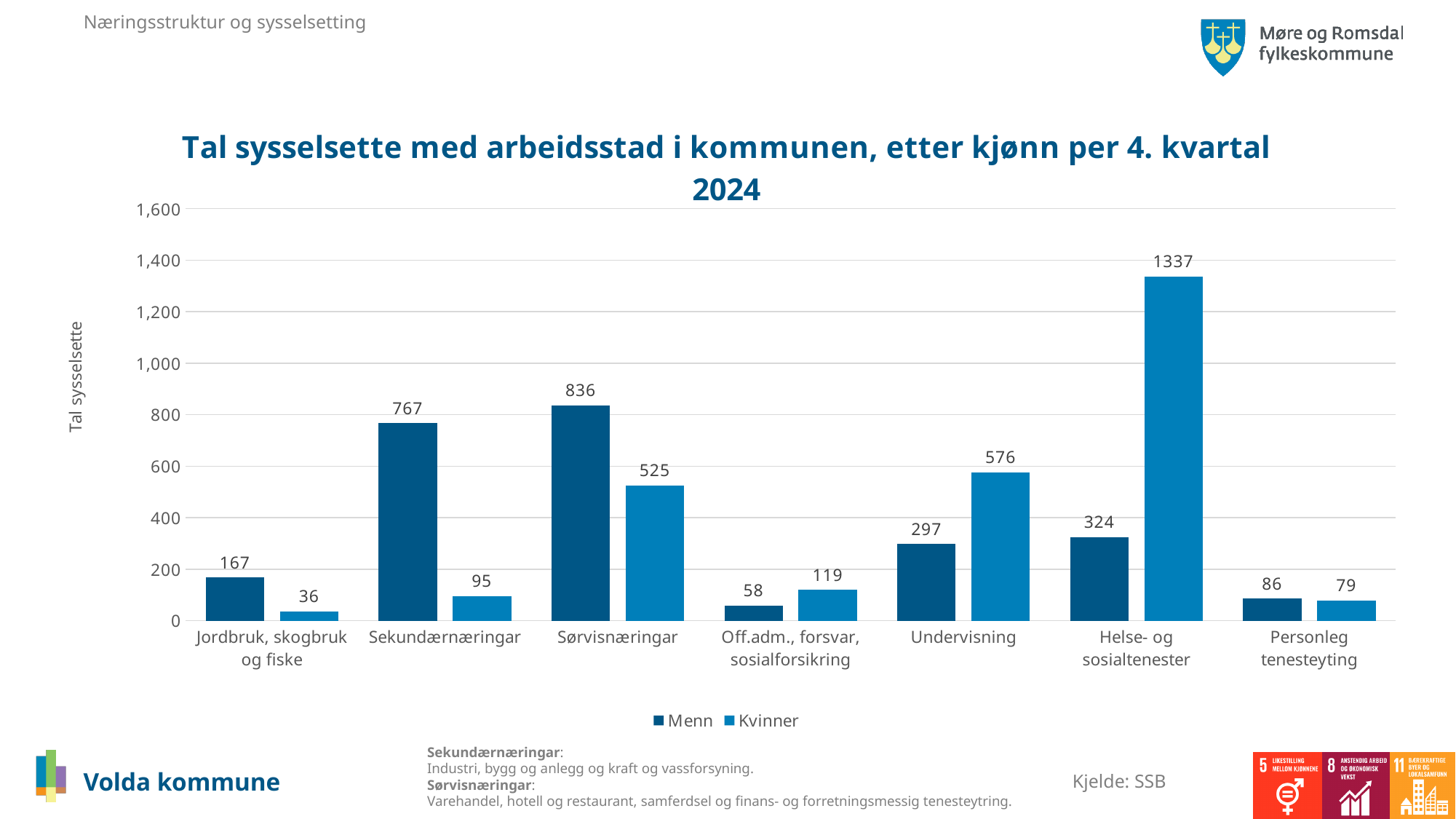
Which is larger in Undervisning, Menn or Kvinner? Kvinner What is the value for Menn in Sekundærnæringar? 767 Which category has the lowest value for Menn? Off.adm., forsvar, sosialforsikring What is the value for Kvinner in Jordbruk, skogbruk og fiske? 36 What is the label of the y axis? Tal sysselsette What kind of chart is shown on the slide? bar chart What is the difference between Menn and Kvinner in Sørvisnæringar? 311 Which category has the highest value for Kvinner? Helse- og sosialtenester How many series does the legend list? 2 Is the value for Menn in Helse- og sosialtenester greater or less than 400? less How many categories are shown on the x axis? 7 What is the value for Kvinner in Helse- og sosialtenester? 1337